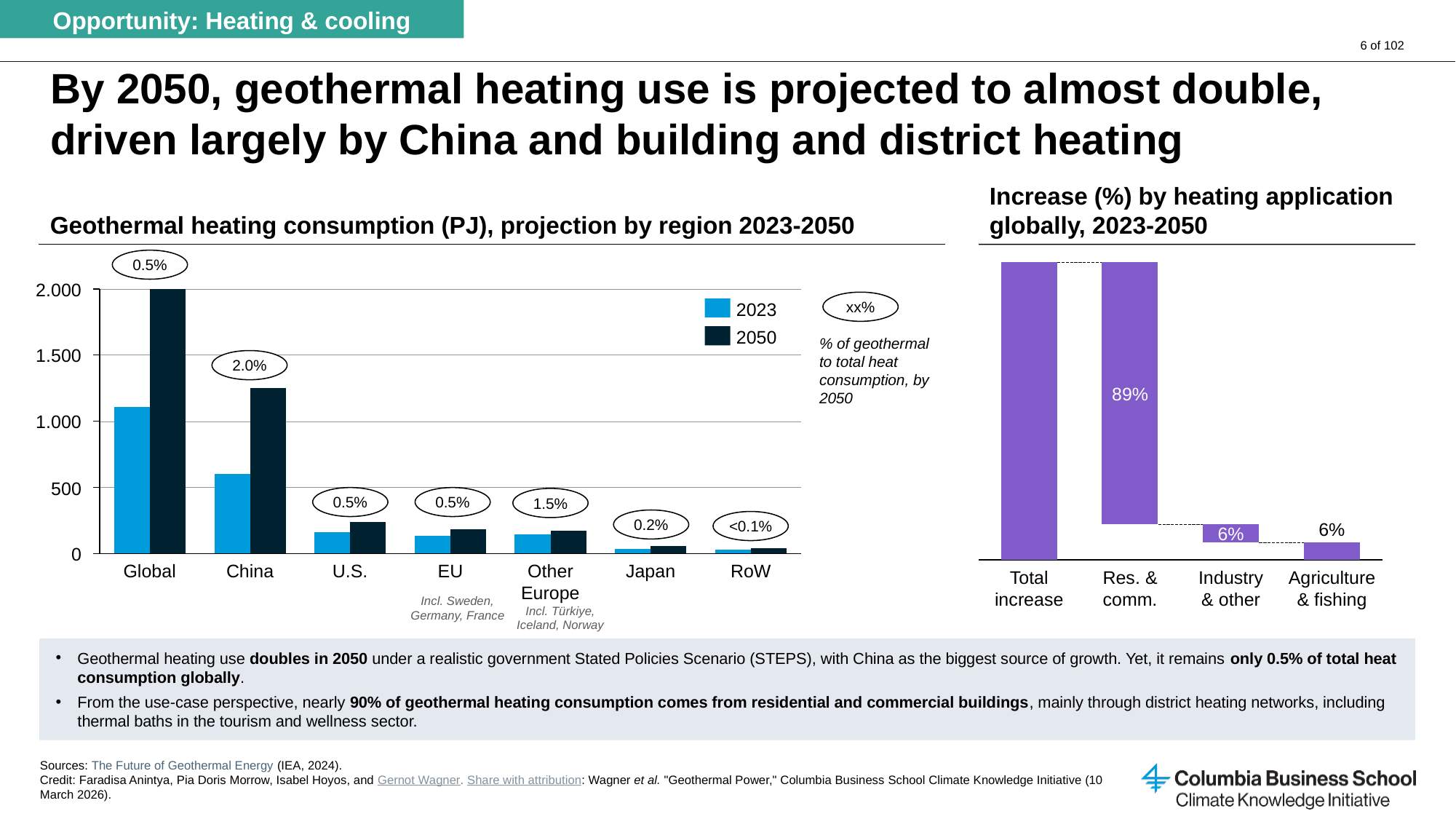
In the 'Geothermal heating consumption (PJ)' chart, which region has the highest 2050 value? Global In the 'Geothermal heating consumption (PJ)' chart, which is larger for 2050: China or U.S.? China How many series does the legend of the 'Geothermal heating consumption (PJ)' chart list? 2 In the 'Geothermal heating consumption (PJ)' chart, what percentage of geothermal to total heat consumption by 2050 is shown in the oval above China? 2.0% In the 'Geothermal heating consumption (PJ)' chart, is the 2023 value for China greater or less than 500? greater How many regions are shown on the x axis of the 'Geothermal heating consumption (PJ)' chart? 7 In the 'Geothermal heating consumption (PJ)' chart, what is the 2050 value for Global? 2.000 In the 'Increase (%) by heating application globally, 2023-2050' chart, what is the value for Industry & other? 6% How many categories are shown on the x axis of the 'Increase (%) by heating application globally, 2023-2050' chart? 4 In the 'Increase (%) by heating application globally, 2023-2050' chart, what is the value for Res. & comm.? 89% In the 'Geothermal heating consumption (PJ)' chart, is the 2023 value for Global greater or less than 1.000? greater What kind of chart is the 'Geothermal heating consumption (PJ), projection by region 2023-2050' chart? bar chart